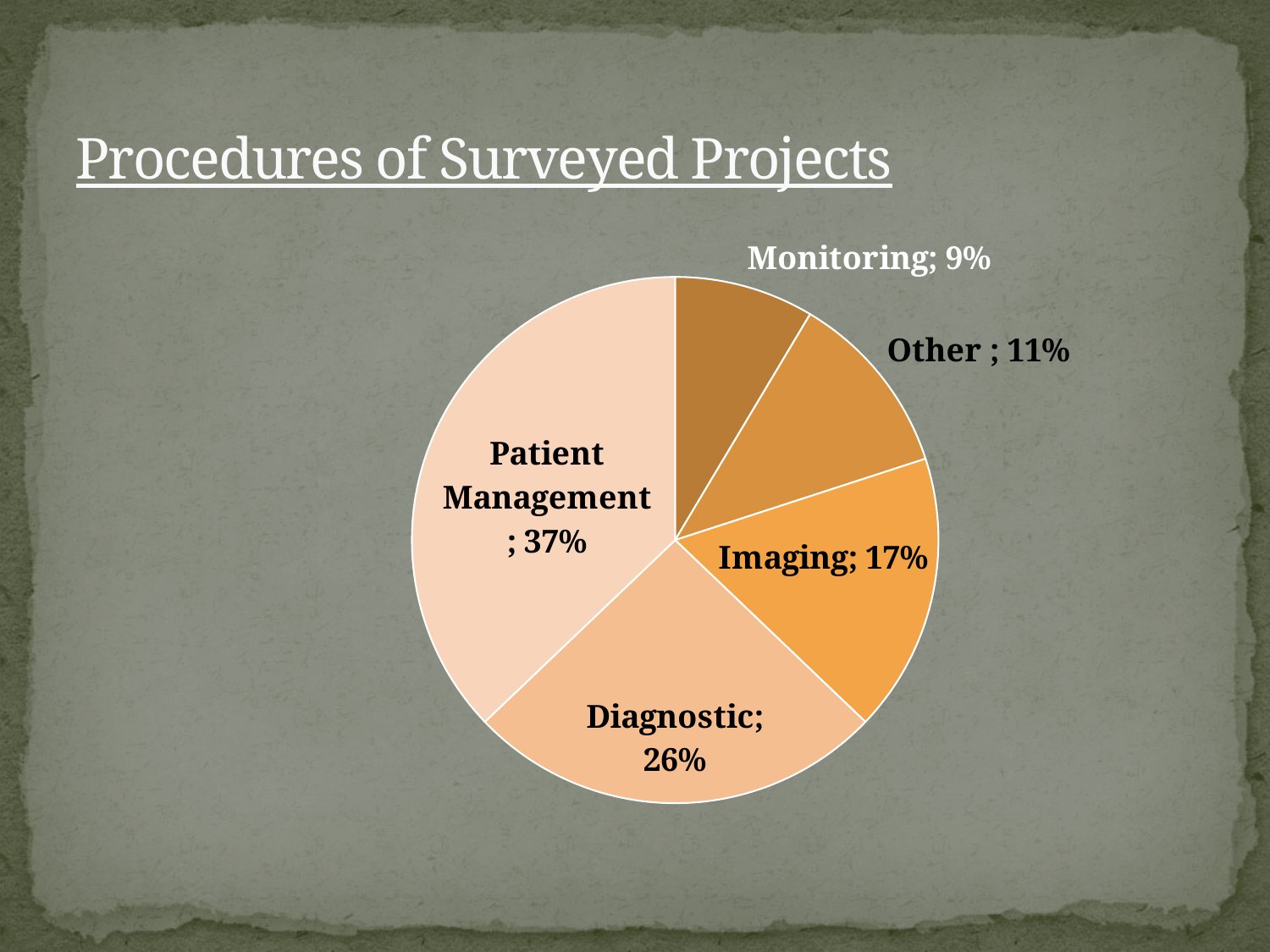
What percentage of the pie is Monitoring? 9% Which category has the largest share of the pie? Patient Management What percentage of the pie is Diagnostic? 26% Which category has the smallest share of the pie? Monitoring What is the title of the chart? Procedures of Surveyed Projects What percentage of the pie is Other? 11% What percentage of the pie is Imaging? 17% What percentage of the pie is Patient Management? 37% What is the difference in percentage points between Patient Management and Diagnostic? 11 Which is larger, the share for Imaging or the share for Other? Imaging How many slices does the pie chart have? 5 What type of chart is shown on the slide? pie chart